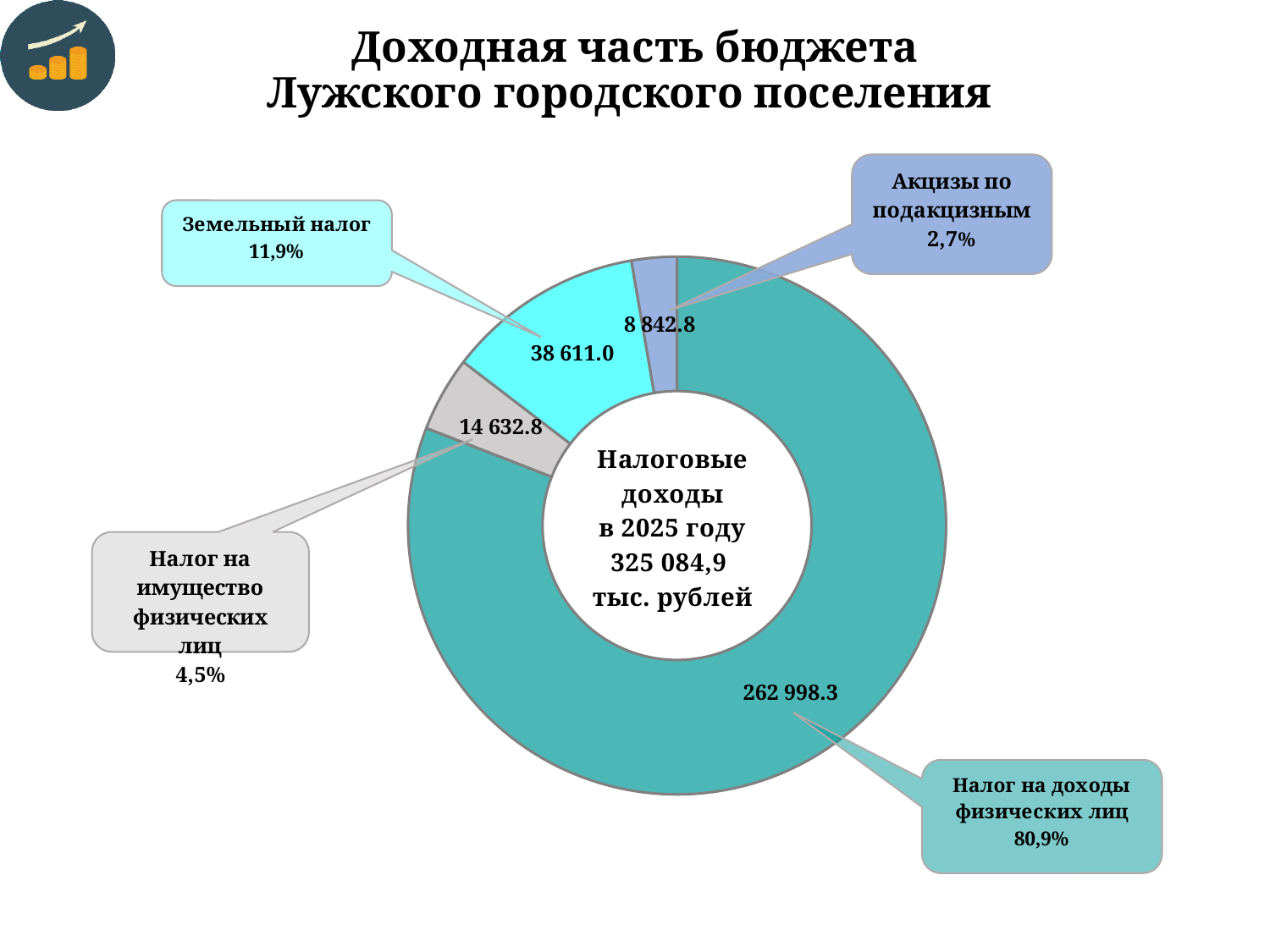
Which category has the smallest slice? Акцизы по подакцизным What is the difference between the values for Земельный налог and Налог на имущество физических лиц? 23 978.2 What kind of chart is shown on the slide? Doughnut chart What total is shown in the centre of the chart for Налоговые доходы в 2025 году? 325 084,9 тыс. рублей What share of the chart does Налог на имущество физических лиц represent? 4,5% What is the value for Земельный налог? 38 611.0 How many slices does the chart have? 4 What is the value for Налог на имущество физических лиц? 14 632.8 What is the value for Акцизы по подакцизным? 8 842.8 Which category has the largest slice? Налог на доходы физических лиц What is the value for Налог на доходы физических лиц? 262 998.3 What share of the chart does Земельный налог represent? 11,9%